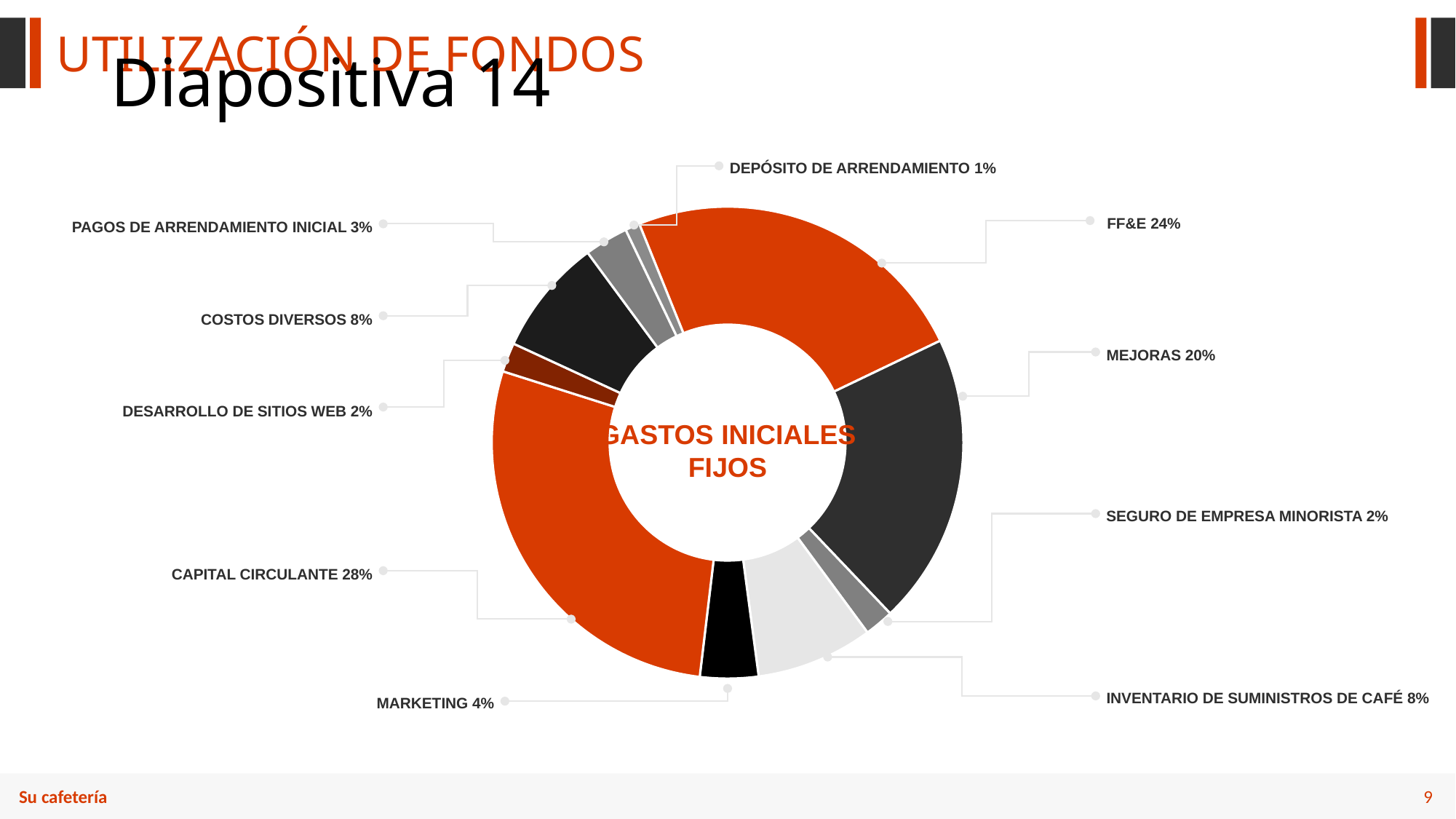
What is the difference in percentage points between CAPITAL CIRCULANTE and FF&E? 4 What percentage is shown for INVENTARIO DE SUMINISTROS DE CAFÉ? 8% What percentage is shown for MEJORAS? 20% What is the title shown in the centre of the chart? GASTOS INICIALES FIJOS Which category has the largest share of the chart? CAPITAL CIRCULANTE What share of the chart does COSTOS DIVERSOS represent? 8% What percentage is shown for CAPITAL CIRCULANTE? 28% Which category has the smallest share of the chart? DEPÓSITO DE ARRENDAMIENTO What percentage is shown for FF&E? 24% How many categories are shown in the chart? 10 What type of chart is shown on the slide? Pie chart (donut) Which is larger, MARKETING or PAGOS DE ARRENDAMIENTO INICIAL? MARKETING